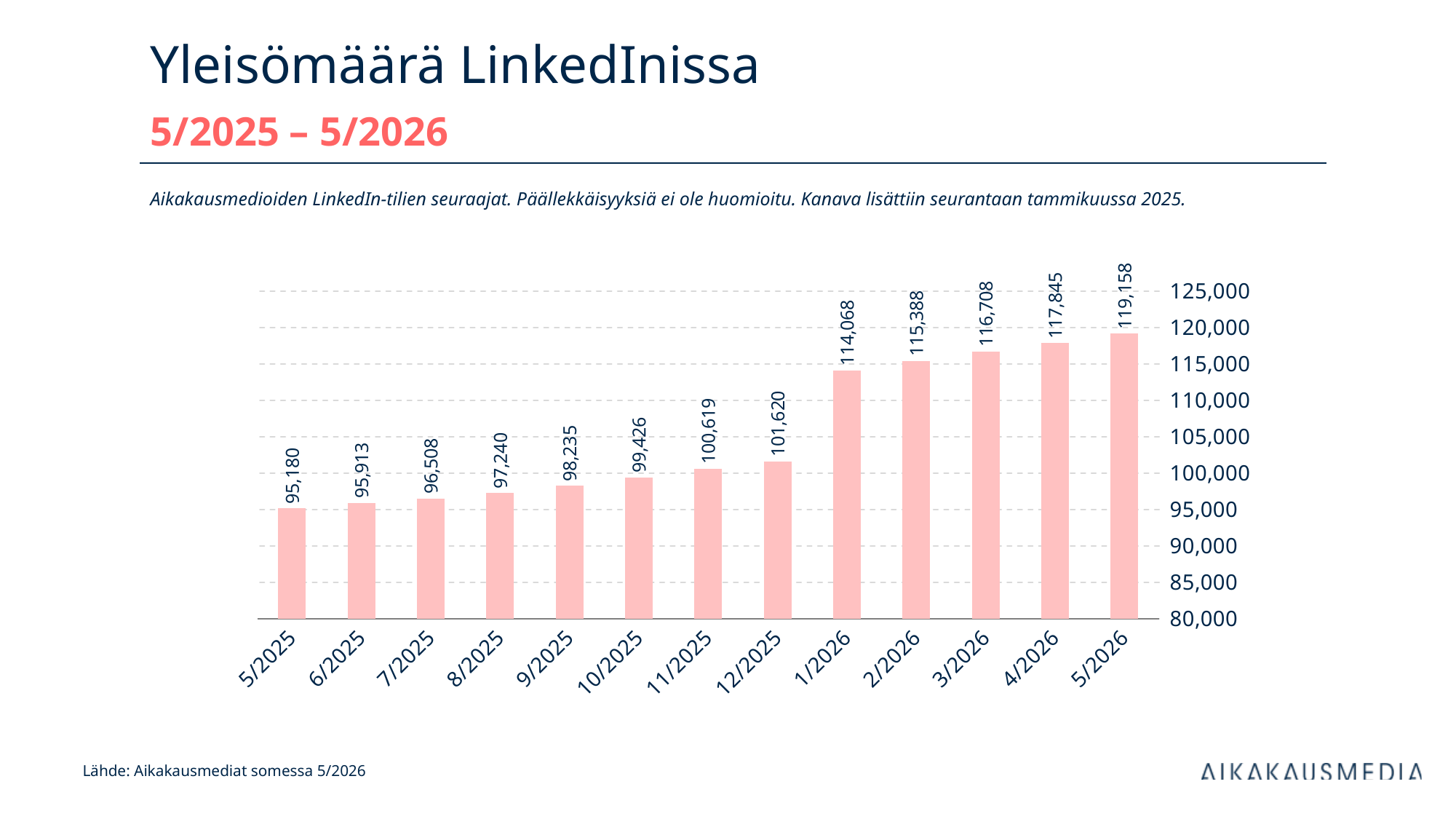
What is the value for 12/2025? 101,620 What kind of chart is shown on the slide? bar chart Which month has the lowest value? 5/2025 What is the difference between the values for 1/2026 and 12/2025? 12,448 Do the values rise or fall from 5/2025 to 5/2026? rise What is the value for 5/2025? 95,180 How many months are shown on the x axis? 13 Is the value for 11/2025 greater or less than 100,000? greater What is the value for 1/2026? 114,068 What is the difference between the values for 5/2026 and 5/2025? 23,978 Which is larger, the value for 9/2025 or the value for 3/2026? 3/2026 Which month has the highest value? 5/2026